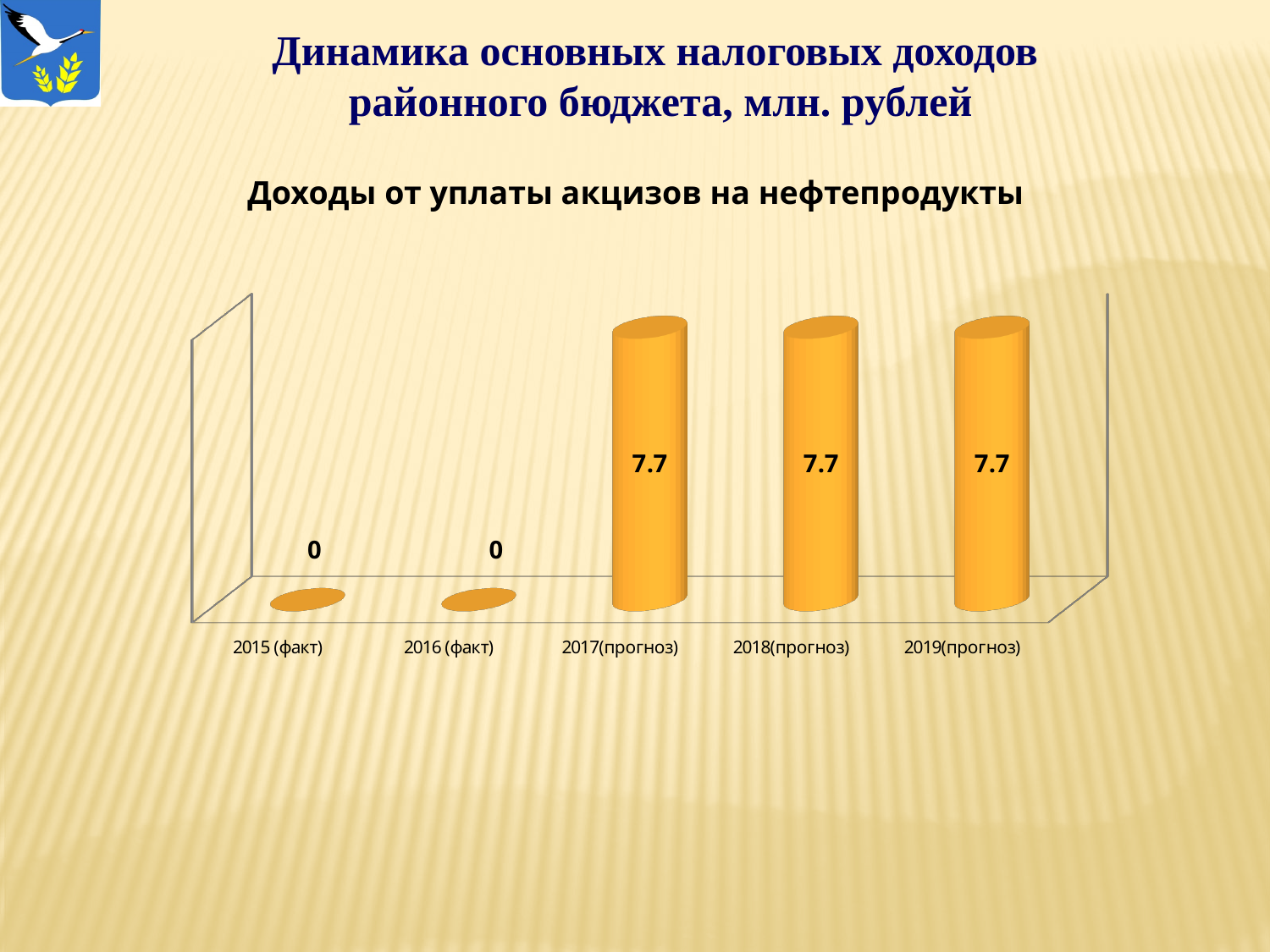
What unit is stated in the slide heading for the values? млн. рублей What is the value for 2015 (факт)? 0 Which is larger, the value for 2018(прогноз) or the value for 2015 (факт)? 2018(прогноз) What is the value for 2017(прогноз)? 7.7 What is the difference between the values for 2017(прогноз) and 2016 (факт)? 7.7 What kind of chart is shown on the slide? bar chart What is the value for 2016 (факт)? 0 Do the values rise or fall from 2016 (факт) to 2017(прогноз)? rise What is the value for 2019(прогноз)? 7.7 How many categories are shown on the x axis? 5 What is the title of the chart? Доходы от уплаты акцизов на нефтепродукты What is the total of the values for 2017(прогноз), 2018(прогноз) and 2019(прогноз)? 23.1